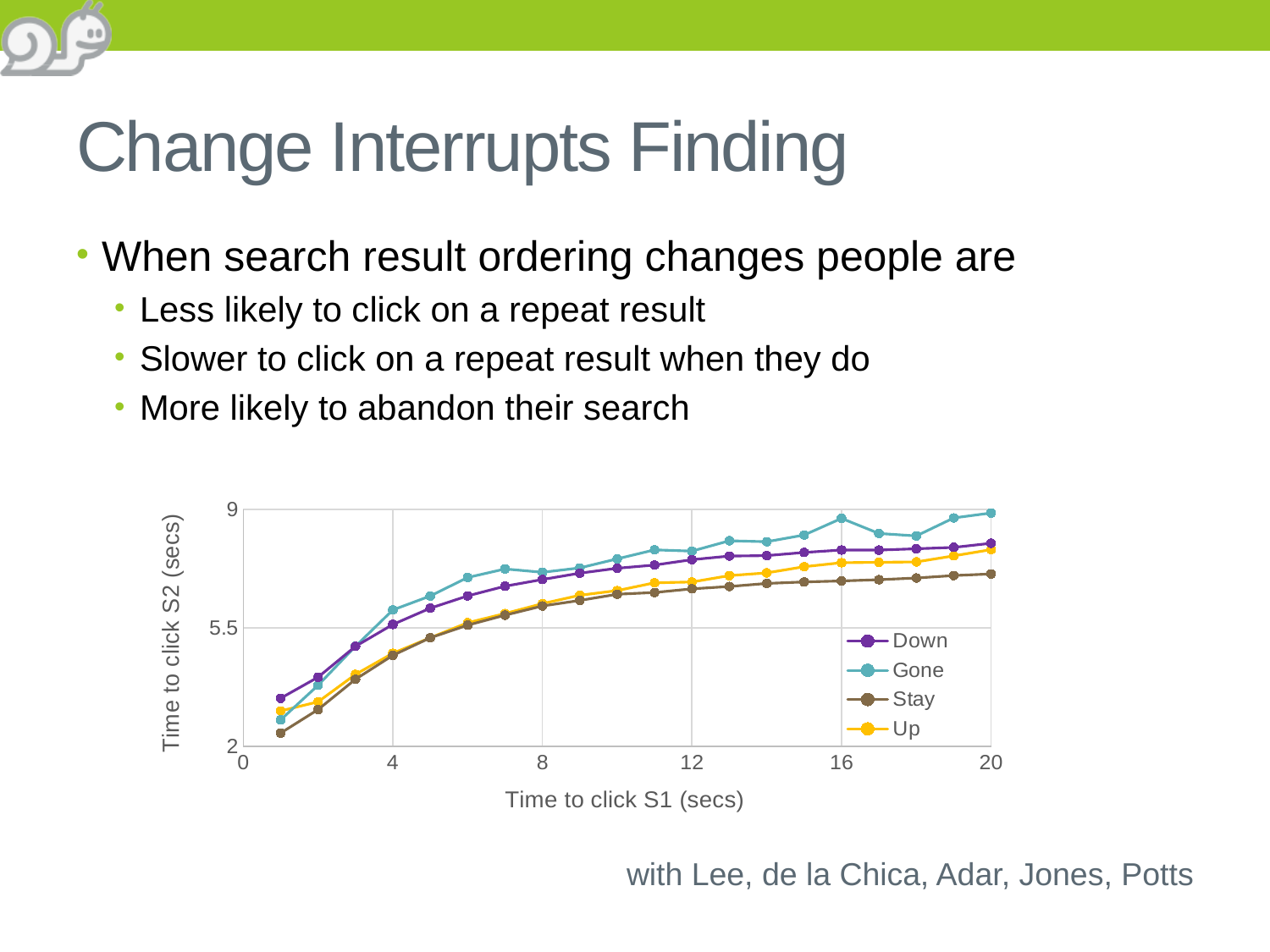
What is the title of the chart's x axis? Time to click S1 (secs) Which series has the lowest value at Time to click S1 = 20? Stay What kind of chart is shown on the slide? line chart At Time to click S1 = 20, which series has the higher value, Gone or Stay? Gone Do the values of the Gone series generally rise or fall as Time to click S1 increases? rise Is the value of the Gone series at Time to click S1 = 16 greater or less than 5.5? greater Is the value of the Stay series at Time to click S1 = 1 greater or less than 5.5? less What are the series names listed in the chart's legend? Down, Gone, Stay, Up Is the value of the Down series at Time to click S1 = 20 greater or less than 5.5? greater How many series does the chart's legend list? 4 Which series has the highest value at Time to click S1 = 20? Gone At Time to click S1 = 1, which series has the higher value, Down or Stay? Down